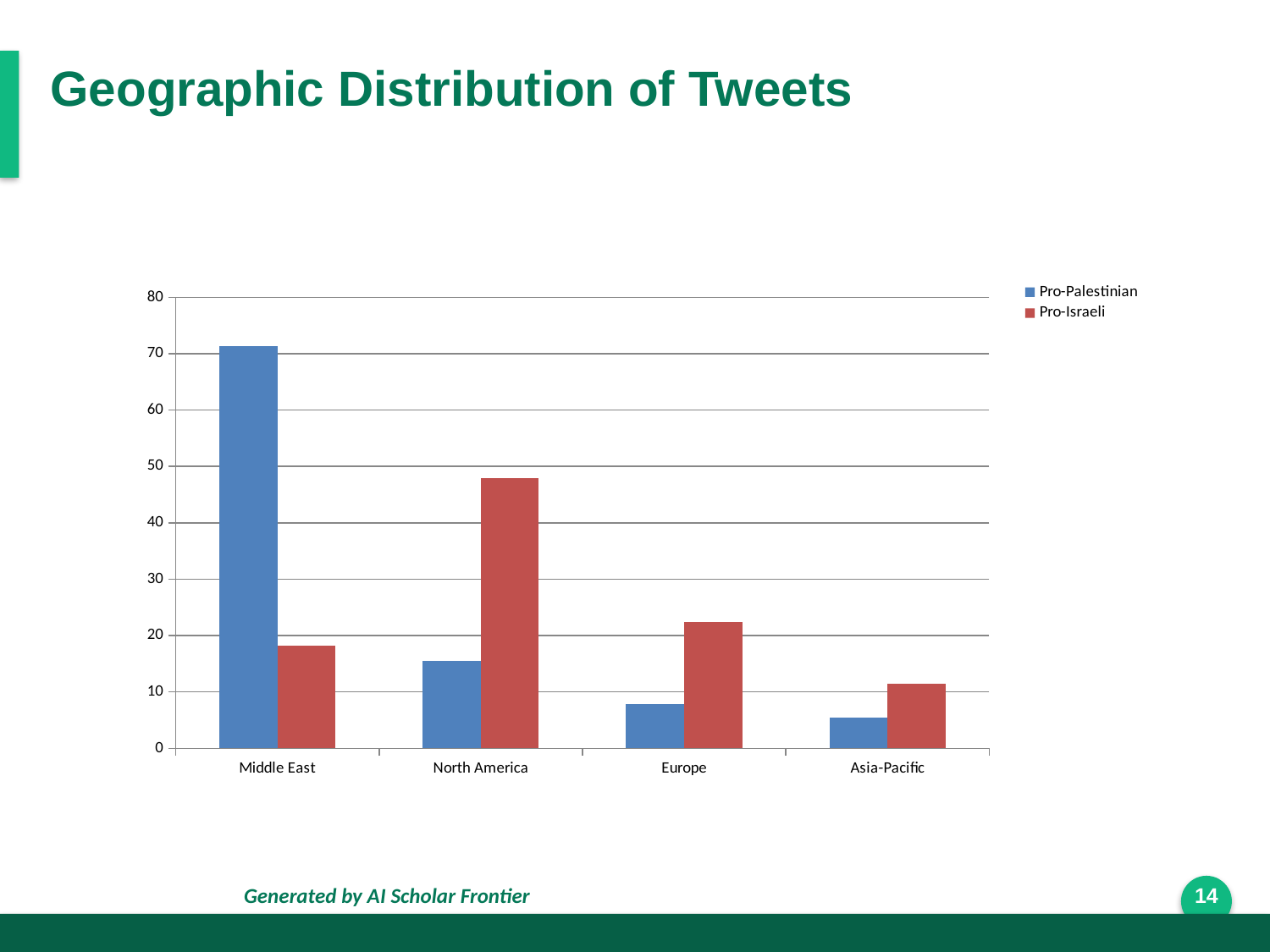
Which region has the lowest Pro-Palestinian value? Asia-Pacific How many regions are shown on the x axis? 4 Which region has the lowest Pro-Israeli value? Asia-Pacific Which region has the highest Pro-Israeli value? North America What kind of chart is shown on the slide? bar chart Is the Pro-Palestinian value for Middle East greater or less than 70? greater Is the Pro-Israeli value for Europe greater or less than 20? greater Which region has the highest Pro-Palestinian value? Middle East In Europe, which series has the larger value, Pro-Palestinian or Pro-Israeli? Pro-Israeli What is the title of the slide containing the chart? Geographic Distribution of Tweets How many series does the legend list? 2 Is the Pro-Israeli value for North America greater or less than 50? less